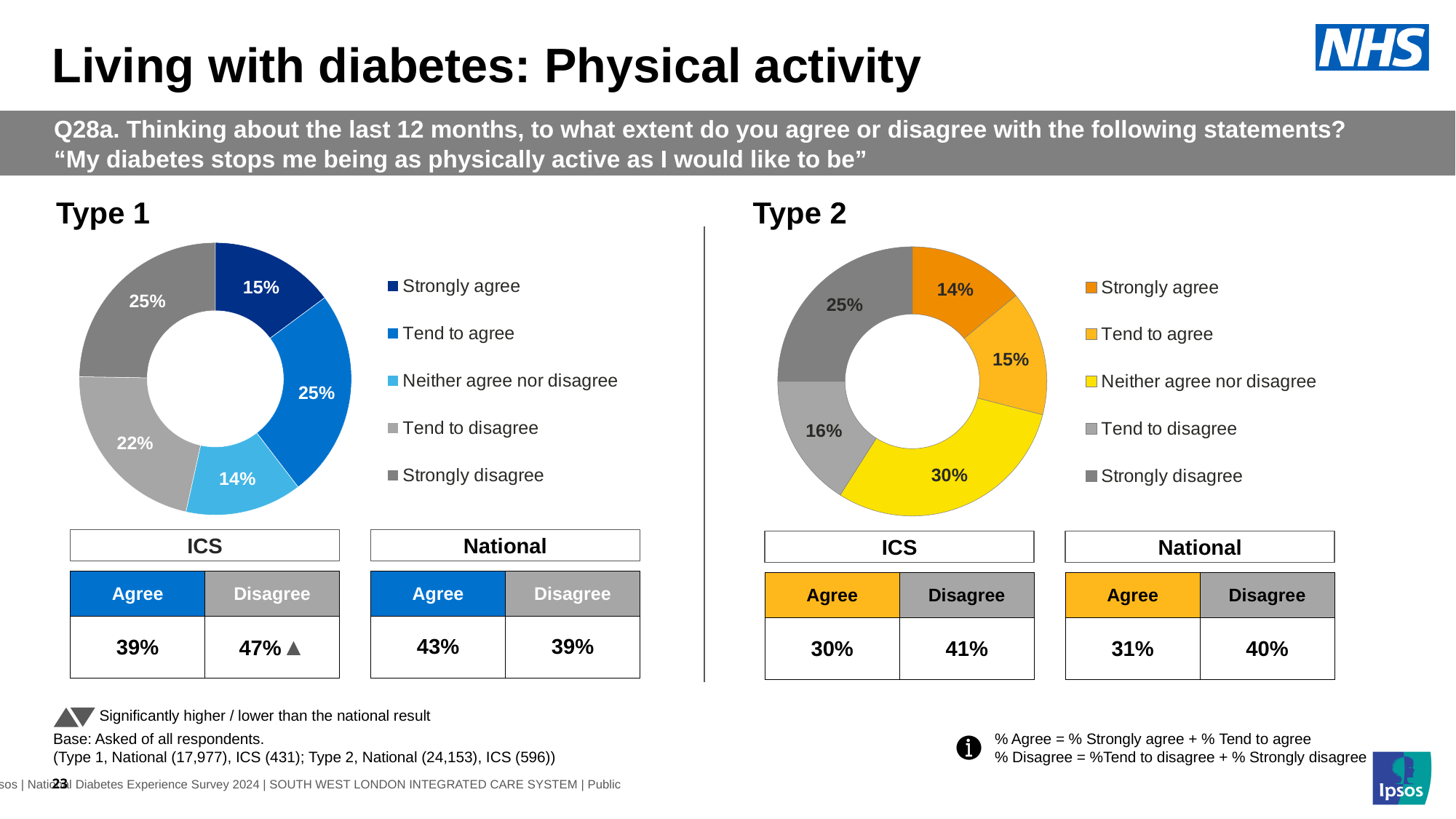
What kind of chart is used for the Type 2 results? Donut (pie) chart How many response categories does the Type 1 chart show? 5 In the Type 2 chart, what percentage of respondents said they neither agree nor disagree? 30% In the Type 2 chart, what is the difference between the Strongly disagree share and the Strongly agree share? 11 percentage points In the Type 2 chart, which is larger: the Neither agree nor disagree share or the Strongly disagree share? Neither agree nor disagree In the Type 2 chart, which response category has the largest share? Neither agree nor disagree In the Type 1 chart, what percentage of respondents said they strongly agree? 15% In the Type 1 chart, what is the difference between the Tend to agree share and the Neither agree nor disagree share? 11 percentage points In the Type 2 chart, what percentage of respondents said they tend to disagree? 16% In the Type 2 chart, what colour represents Neither agree nor disagree? Yellow In the Type 1 chart, which is larger: the Tend to agree share or the Tend to disagree share? Tend to agree In the Type 1 chart, what percentage of respondents said they tend to disagree? 22%